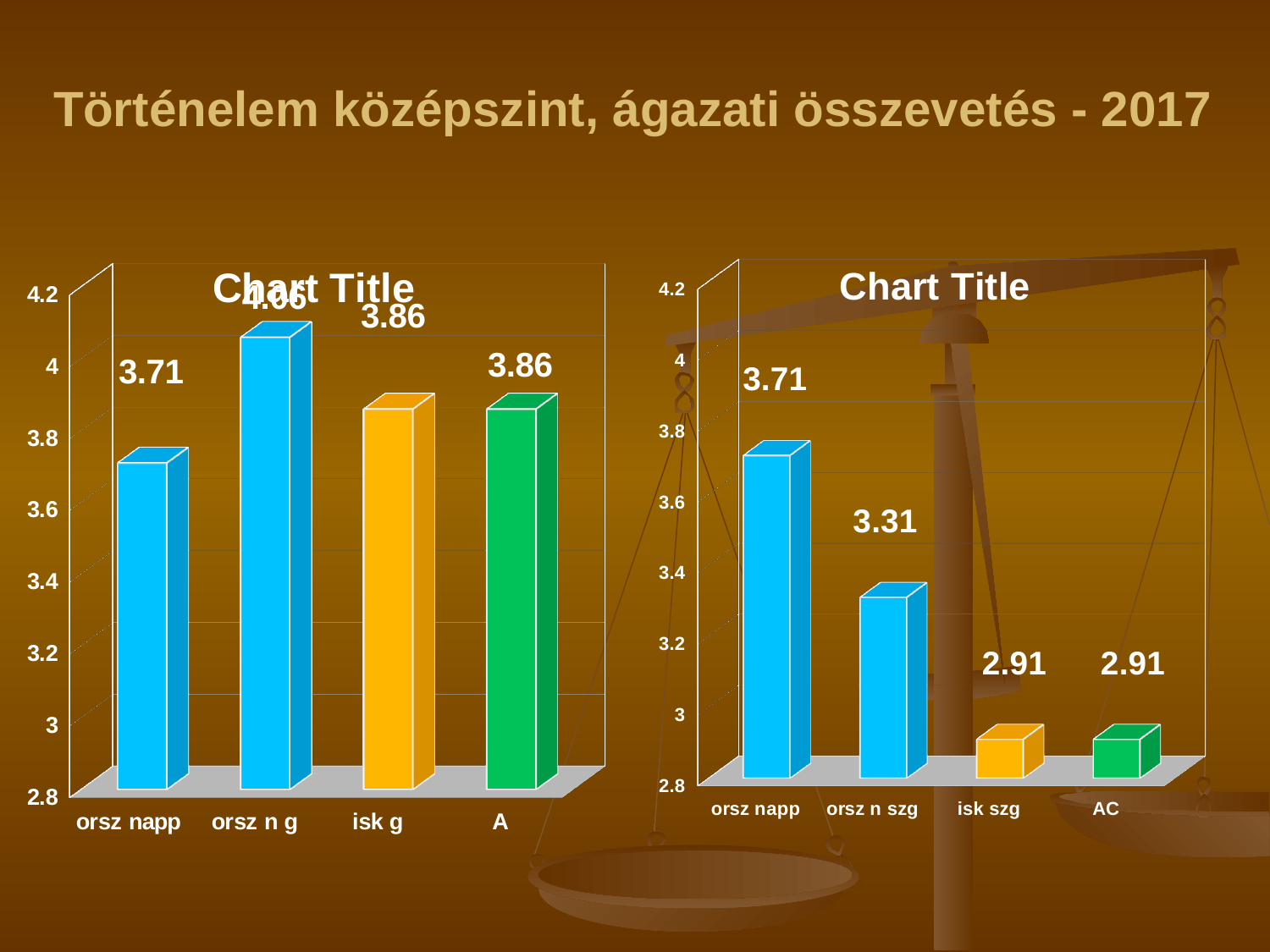
In the right chart, what is the value for orsz n szg? 3.31 In the left chart, what is the difference between the values for isk g and orsz napp? 0.15 How many categories are shown in the right chart? 4 In the left chart, what is the value for A? 3.86 In the right chart, what is the value for isk szg? 2.91 In the right chart, what is the difference between the values for orsz napp and orsz n szg? 0.4 In the left chart, what is the value for orsz napp? 3.71 In the left chart, which category has the lowest value? orsz napp In the left chart, which category has the highest value? orsz n g In the right chart, which category has the highest value? orsz napp In the left chart, what is the value for isk g? 3.86 What kind of chart is the left chart? bar chart